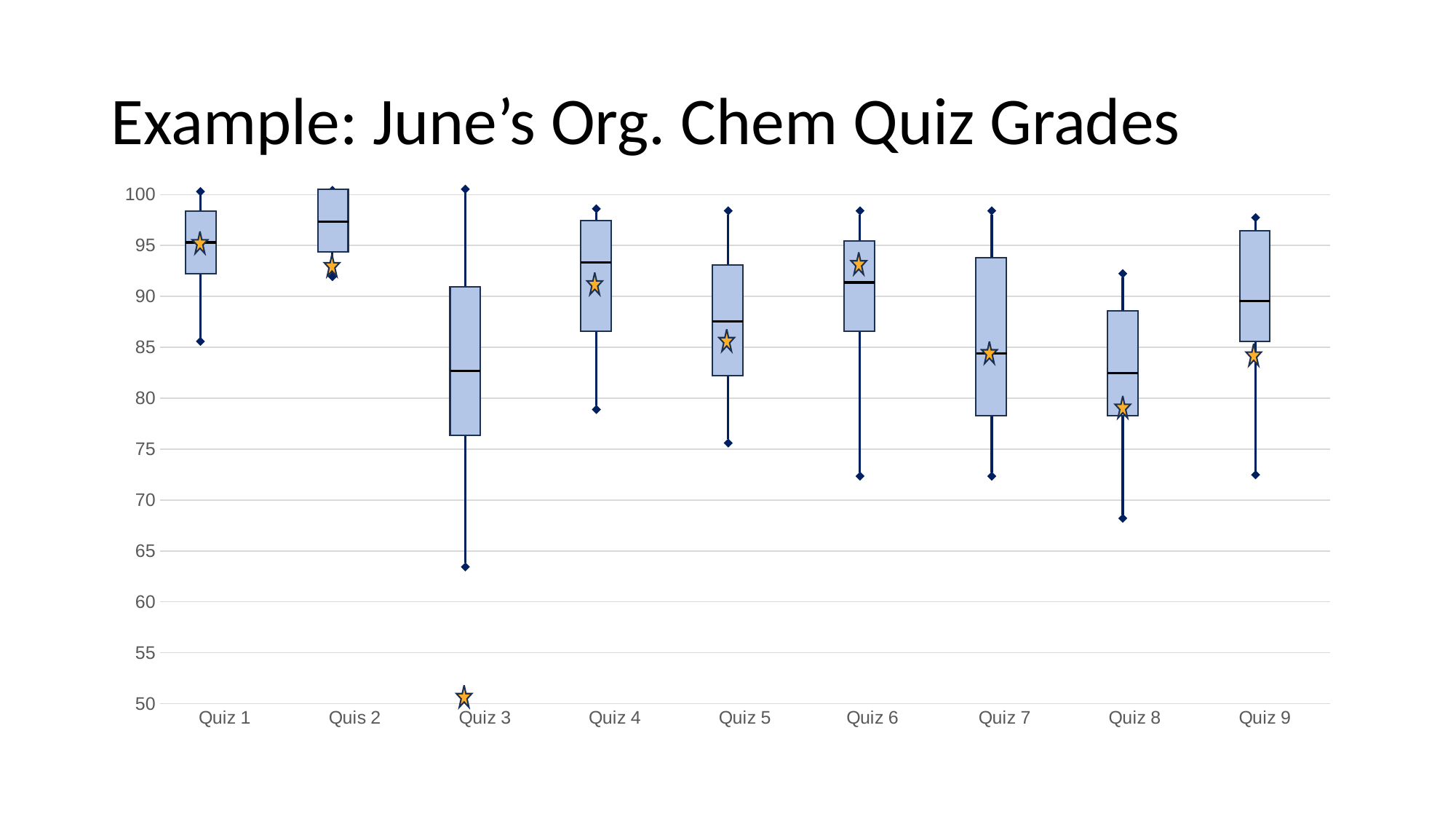
Is the lower whisker end for Quiz 3 greater or less than 65? less Is the median line for Quiz 8 greater or less than 85? less What kind of chart is shown on the slide? Box-and-whisker chart Is the star marker for Quiz 3 greater or less than 55? less What is the title of the slide containing the chart? Example: June's Org. Chem Quiz Grades Which quiz has the lowest whisker minimum? Quiz 3 Which quiz has the highest median line? Quis 2 Which quiz has the lowest star marker? Quiz 3 How many quizzes (categories) are plotted on the x axis? 9 Is the star marker for Quiz 1 higher or lower than the star marker for Quiz 8? higher Which quiz has the tallest box (largest interquartile range)? Quiz 3